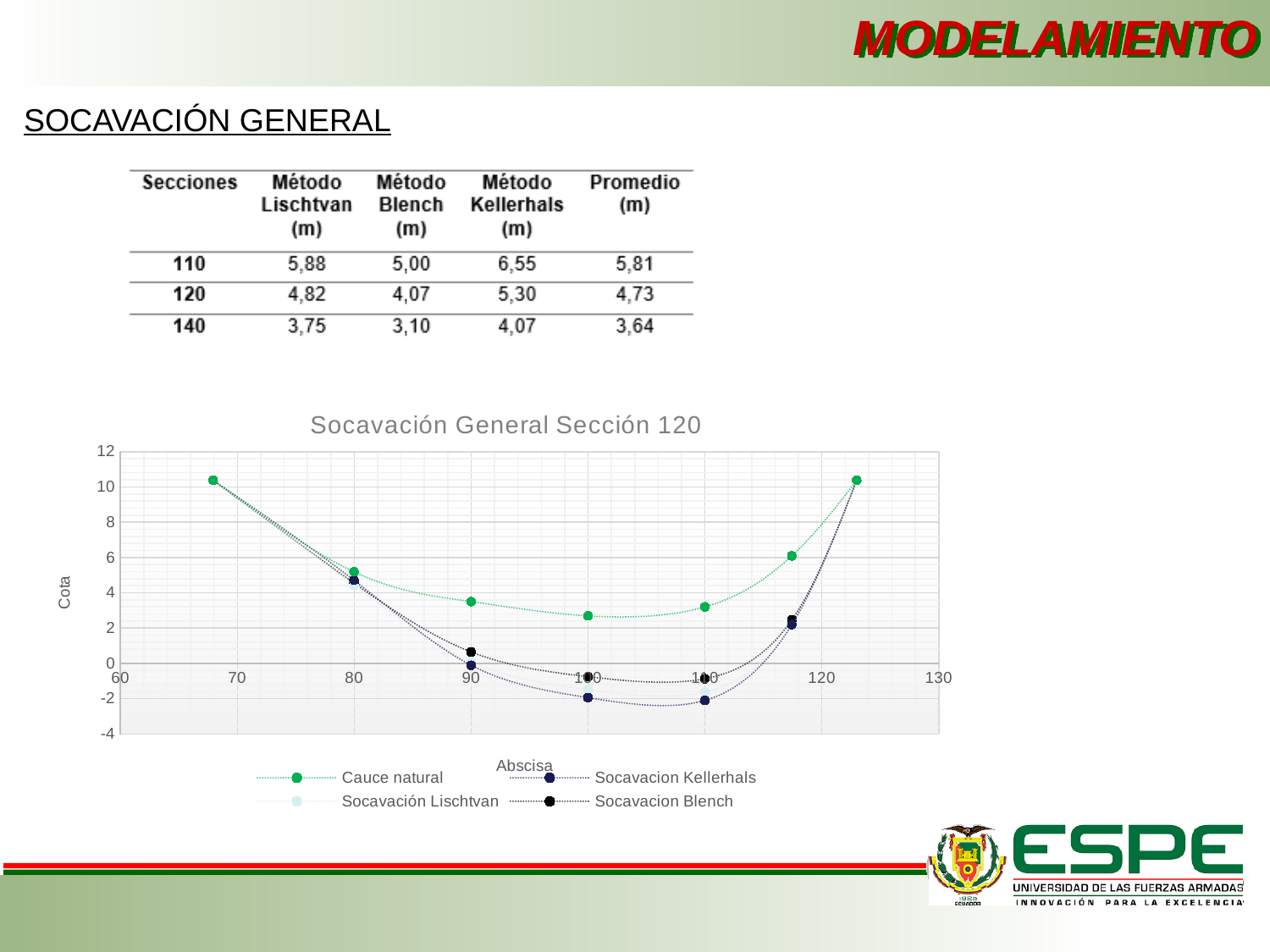
Does the Cauce natural series rise or fall between abscissa 70 and abscissa 100? fall Is the value of the Cauce natural series at abscissa 100 greater or less than 4? less How many series does the legend of the chart list? 4 Is the value of the Socavacion Kellerhals series at abscissa 110 greater or less than 0? less What is the title of the chart on the slide? Socavación General Sección 120 What kind of chart is shown on the slide? Line chart How many data points are plotted for the Cauce natural series? 7 At abscissa 90, which series has the larger value: Socavacion Blench or Socavacion Kellerhals? Socavacion Blench Is the value of the Cauce natural series at abscissa 80 greater or less than 4? greater What is the label of the vertical axis of the chart? Cota At abscissa 100, which series has the larger value: Cauce natural or Socavacion Kellerhals? Cauce natural